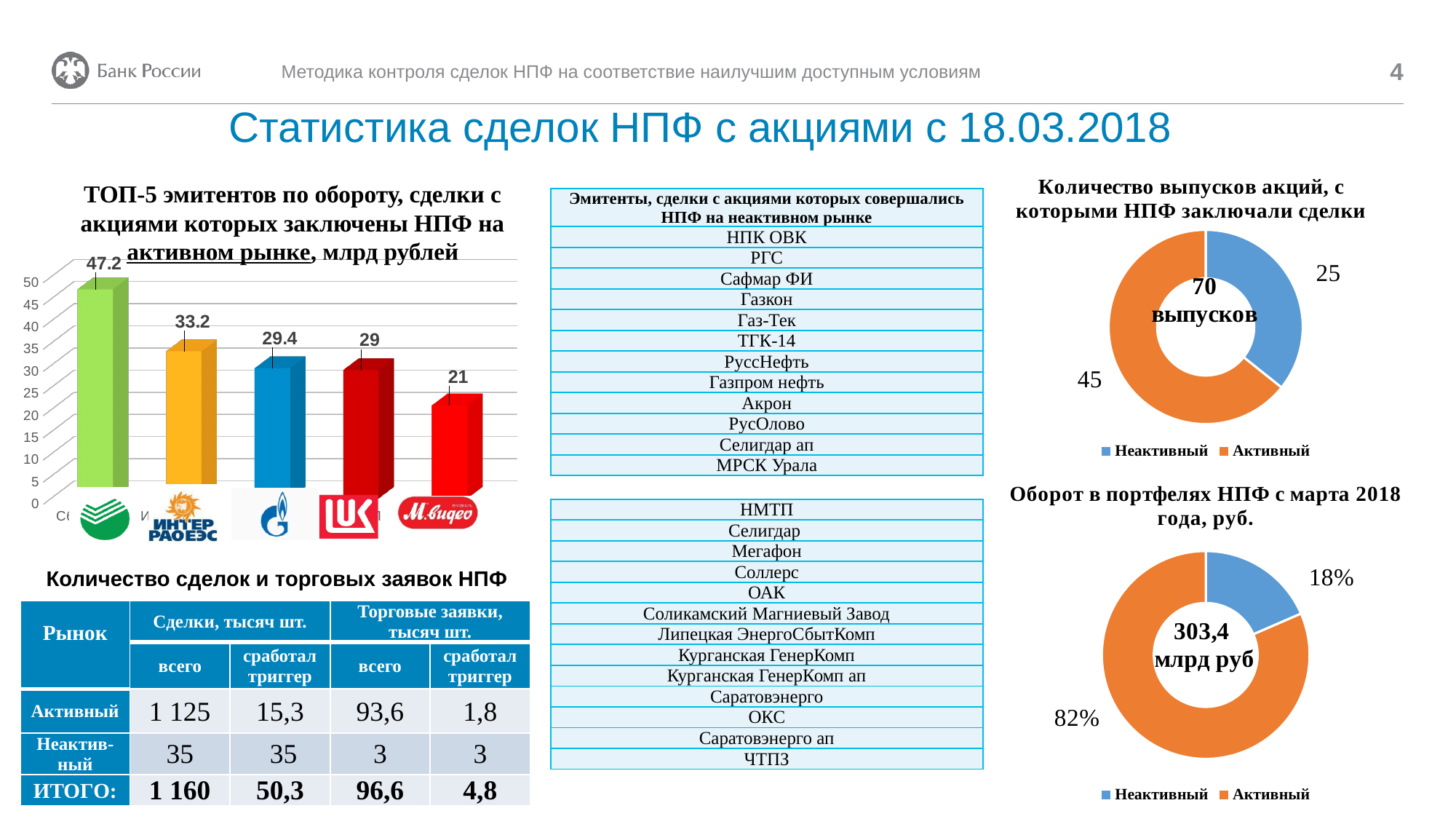
In the doughnut chart 'Оборот в портфелях НПФ с марта 2018 года, руб.', what share does Неактивный have? 18% In the bar chart 'ТОП-5 эмитентов по обороту', what is the difference between the first bar (47.2) and the second bar (33.2)? 14 In the bar chart 'ТОП-5 эмитентов по обороту', what is the value of the shortest (last) bar? 21 How many entries does the legend of the doughnut chart 'Количество выпусков акций, с которыми НПФ заключали сделки' list? 2 In the bar chart 'ТОП-5 эмитентов по обороту', do the values rise or fall from left to right? fall In the doughnut chart 'Оборот в портфелях НПФ с марта 2018 года, руб.', which segment is larger, Активный or Неактивный? Активный In the bar chart 'ТОП-5 эмитентов по обороту', what is the value of the second bar? 33.2 What type of chart is 'ТОП-5 эмитентов по обороту'? bar chart How many bars are shown in the bar chart 'ТОП-5 эмитентов по обороту'? 5 In the doughnut chart 'Количество выпусков акций, с которыми НПФ заключали сделки', what is the value for Активный? 45 In the bar chart 'ТОП-5 эмитентов по обороту', what is the value of the tallest (first) bar? 47.2 In the doughnut chart 'Количество выпусков акций, с которыми НПФ заключали сделки', what is the value for Неактивный? 25